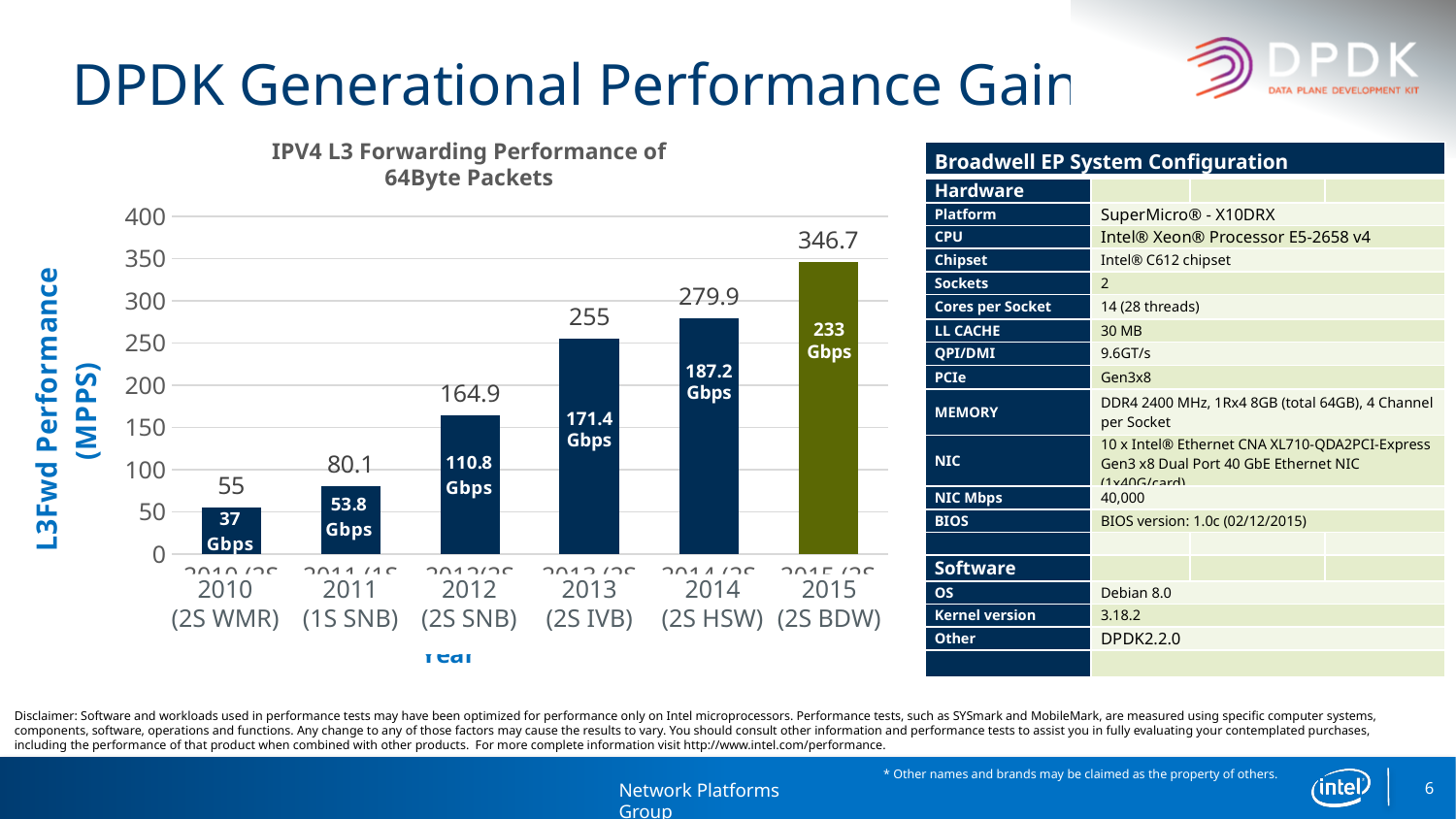
Which year has the highest L3Fwd performance? 2015 (2S BDW) What is the L3Fwd performance in MPPS for 2012 (2S SNB)? 164.9 What is the L3Fwd performance in MPPS for 2015 (2S BDW)? 346.7 Which year has the lowest L3Fwd performance? 2010 (2S WMR) How many years (bars) are shown in the chart? 6 Is the value for 2014 (2S HSW) greater or less than 250 MPPS? greater What type of chart is used to show the IPV4 L3 forwarding performance? Bar chart What is the difference in MPPS between 2014 (2S HSW) and 2013 (2S IVB)? 24.9 Do the MPPS values rise or fall from 2010 to 2015? Rise What Gbps value is labelled inside the bar for 2010 (2S WMR)? 37 Gbps Which is larger, the MPPS value for 2011 (1S SNB) or for 2012 (2S SNB)? 2012 (2S SNB) What Gbps value is labelled inside the bar for 2013 (2S IVB)? 171.4 Gbps